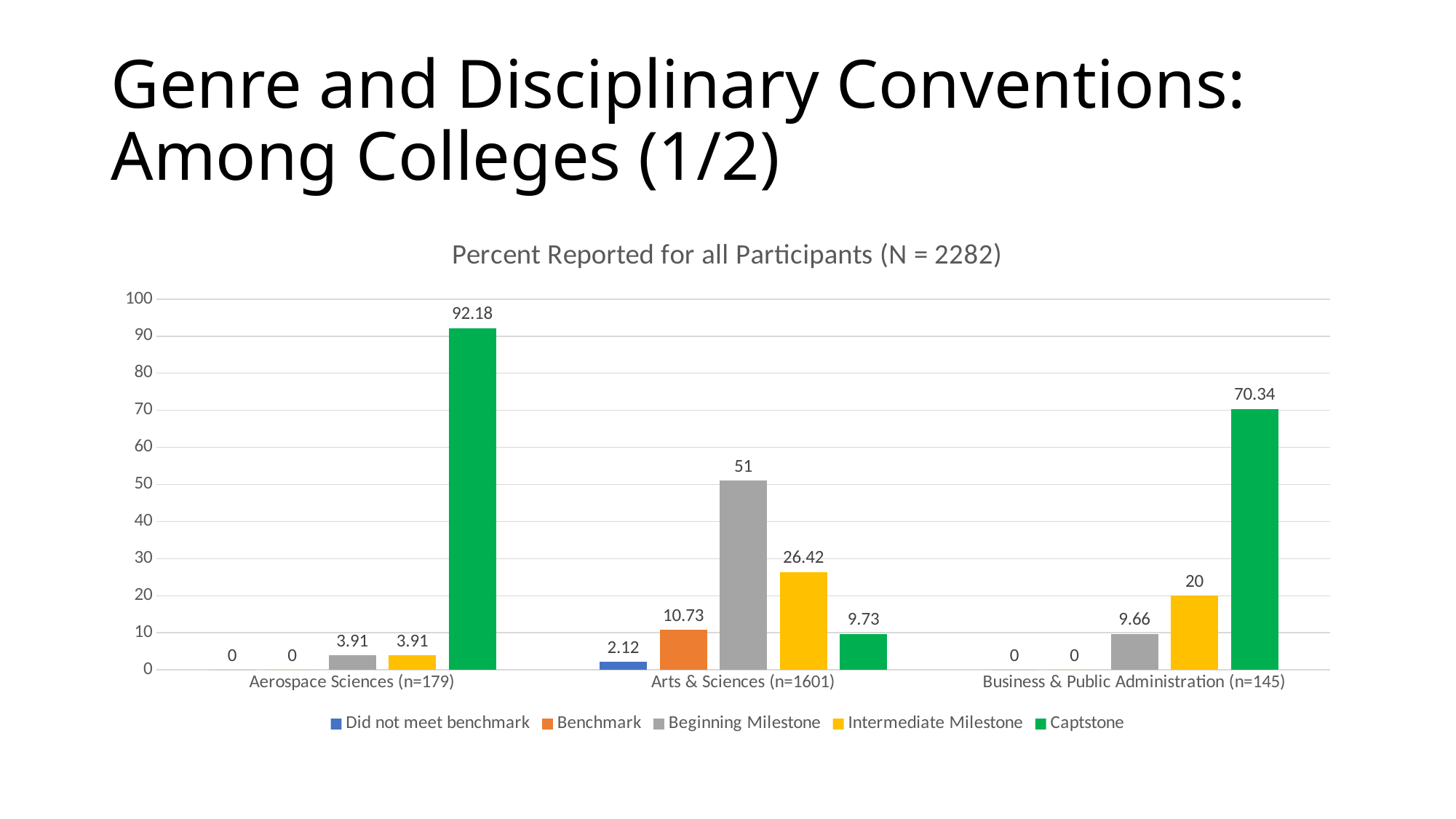
Which college has the lowest Captstone value? Arts & Sciences (n=1601) What is the Benchmark value for Arts & Sciences (n=1601)? 10.73 How many colleges are shown on the x axis? 3 What is the title of the chart? Percent Reported for all Participants (N = 2282) How many series does the legend list? 5 Which college has the highest Captstone value? Aerospace Sciences (n=179) What is the Beginning Milestone value for Arts & Sciences (n=1601)? 51 Which is larger for Arts & Sciences (n=1601): the Beginning Milestone value or the Intermediate Milestone value? Beginning Milestone What kind of chart is shown on the slide? Bar chart What is the Captstone value for Aerospace Sciences (n=179)? 92.18 What is the difference between the Captstone values for Aerospace Sciences (n=179) and Business & Public Administration (n=145)? 21.84 What is the Intermediate Milestone value for Business & Public Administration (n=145)? 20